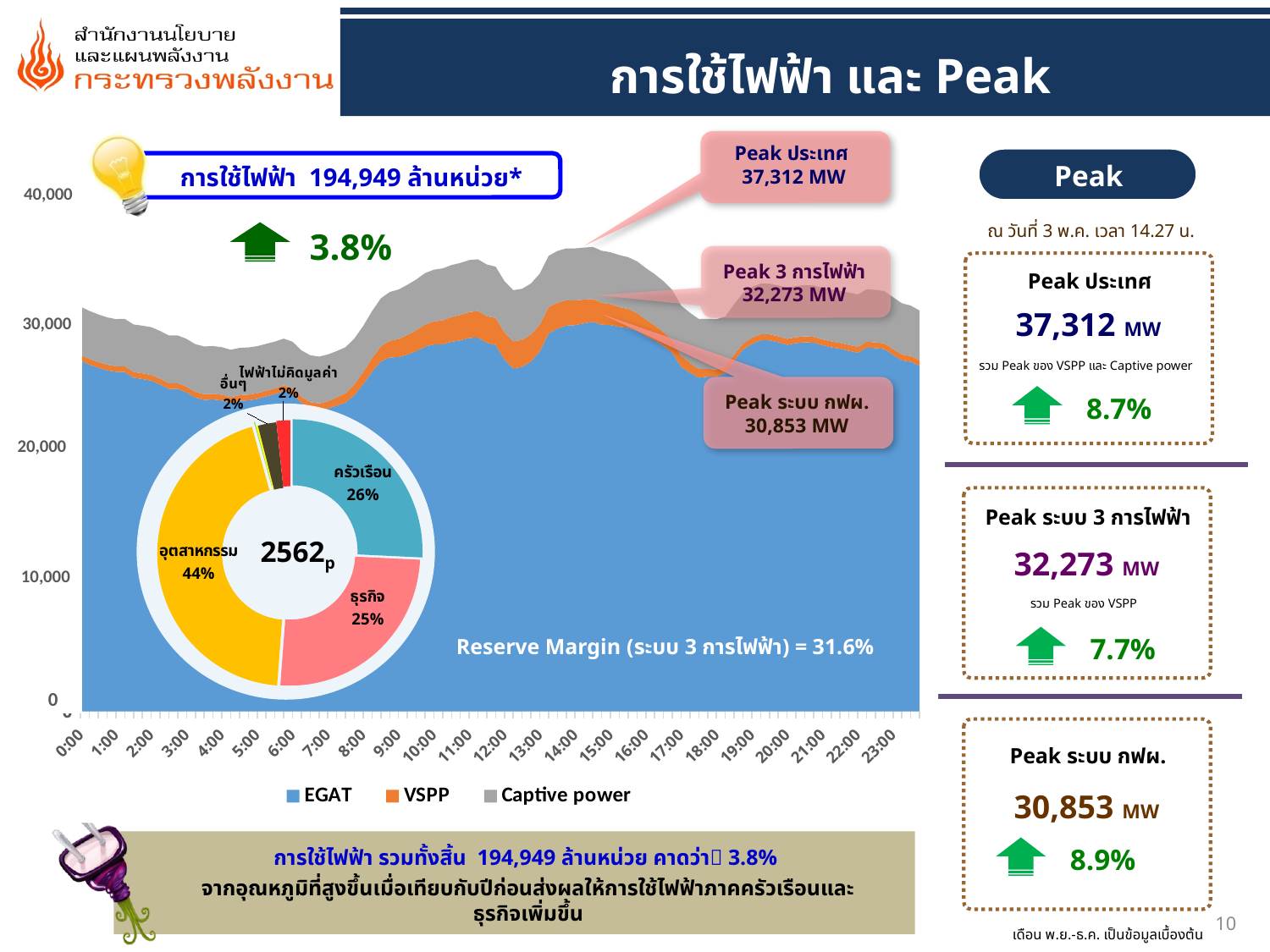
How many series does the legend of the area chart list? 3 What are the three series listed in the legend of the area chart? EGAT, VSPP, Captive power In the donut chart, what is the difference between the shares for อุตสาหกรรม and ธุรกิจ? 19 percentage points What is the Peak ระบบ กฟผ. value labelled on the area chart? 30,853 MW What is the Peak ประเทศ value labelled on the area chart? 37,312 MW What is the difference between Peak ประเทศ and Peak 3 การไฟฟ้า as labelled on the chart? 5,039 MW What year is shown in the centre of the donut chart? 2562p In the donut chart, what share of electricity use is ธุรกิจ? 25% In the donut chart, which sector has the largest share? อุตสาหกรรม In the donut chart, what share of electricity use is อุตสาหกรรม? 44% In the donut chart, what share of electricity use is ครัวเรือน? 26% In the donut chart, which is larger, the share for ครัวเรือน or the share for อื่นๆ? ครัวเรือน